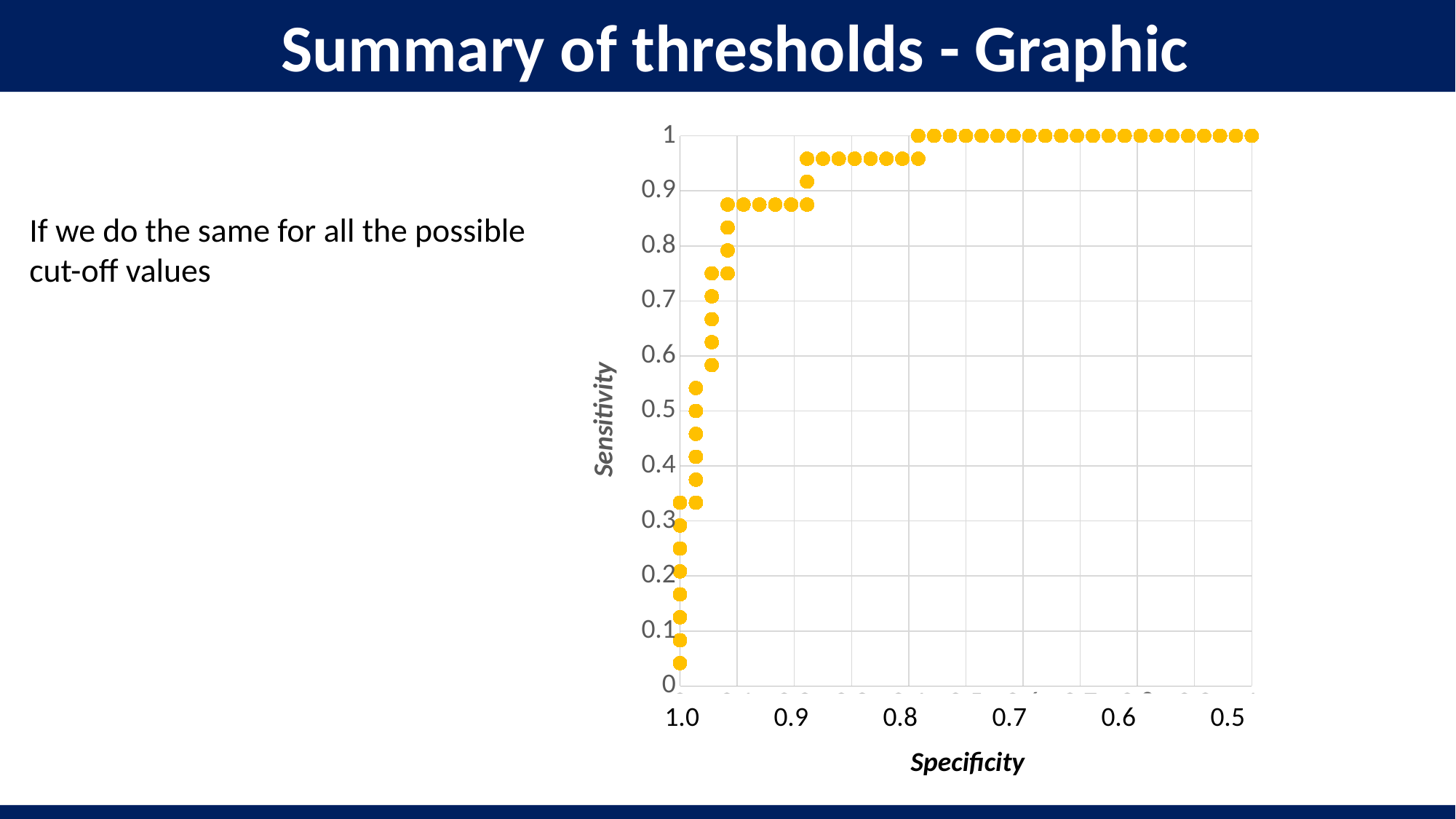
What is the label of the horizontal axis of the chart? Specificity Which has the higher sensitivity: the points at specificity 0.5 or the points at specificity 1.0? Specificity 0.5 Is the sensitivity of the points at specificity 0.7 greater or less than 0.9? greater Is the sensitivity of the points at specificity 0.8 greater or less than 0.9? greater What is the highest sensitivity value reached by the plotted points? 1 What kind of chart is shown on the slide? Scatter chart What is the lowest value shown on the vertical axis of the chart? 0 Are the sensitivity values of the points at specificity 1.0 greater or less than 0.4? less What is the label of the vertical axis of the chart? Sensitivity Moving from left to right along the specificity axis, do the sensitivity values rise or fall? rise